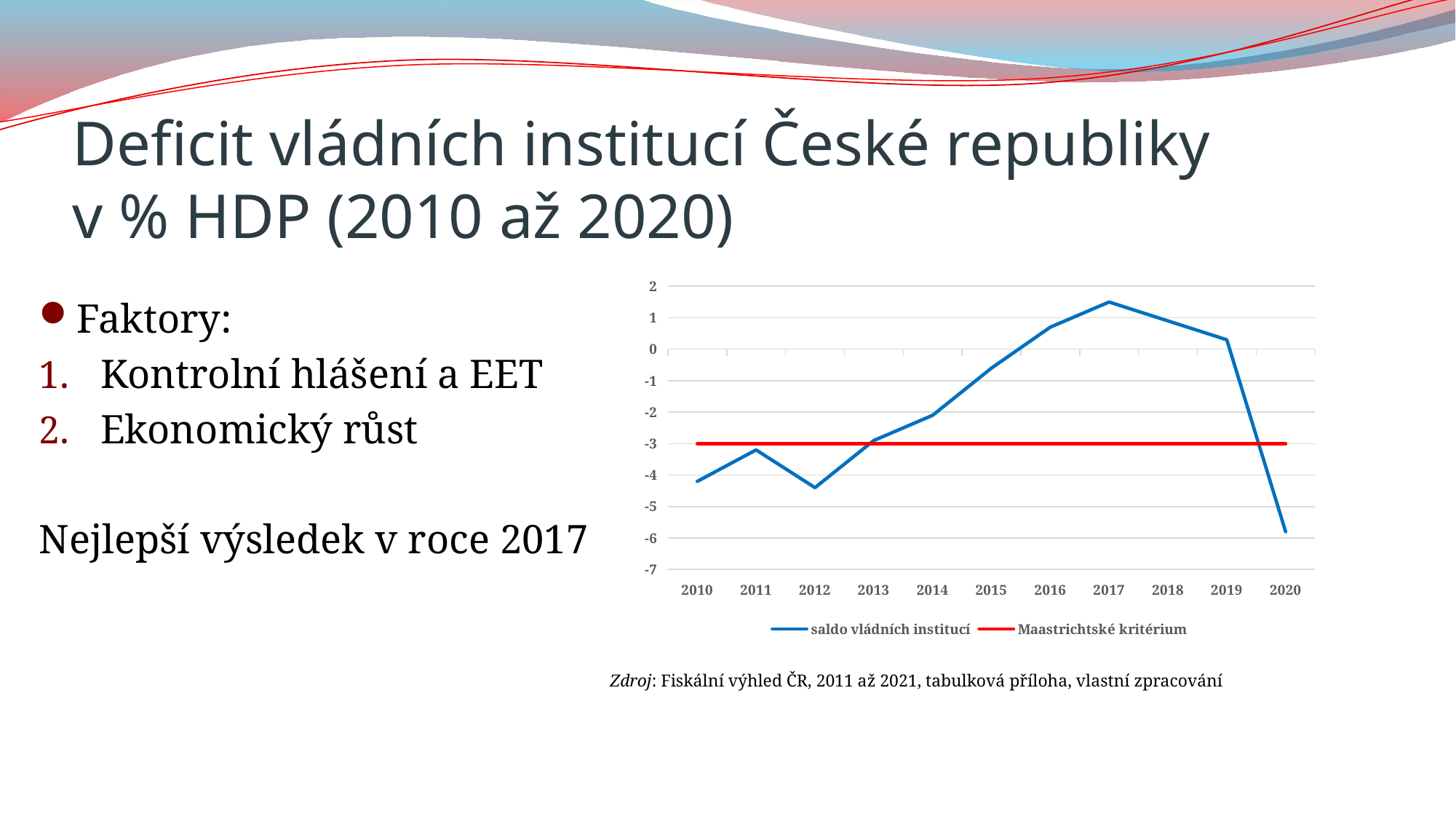
How many years are plotted along the x axis of the chart? 11 What constant value does the 'Maastrichtské kritérium' line sit at? -3 In which year does the 'saldo vládních institucí' line reach its highest value? 2017 How many series does the chart legend list? 2 In which year does the 'saldo vládních institucí' line reach its lowest value? 2020 Is the value of 'saldo vládních institucí' for 2017 greater or less than 1? greater Does the 'saldo vládních institucí' line rise or fall between 2012 and 2017? rise What colour is the 'Maastrichtské kritérium' line in the chart? red Is the value of 'saldo vládních institucí' for 2020 greater or less than -5? less Is the value of 'saldo vládních institucí' for 2010 greater or less than -4? less What kind of chart is shown on the slide? line chart Which year has the higher 'saldo vládních institucí' value, 2011 or 2012? 2011